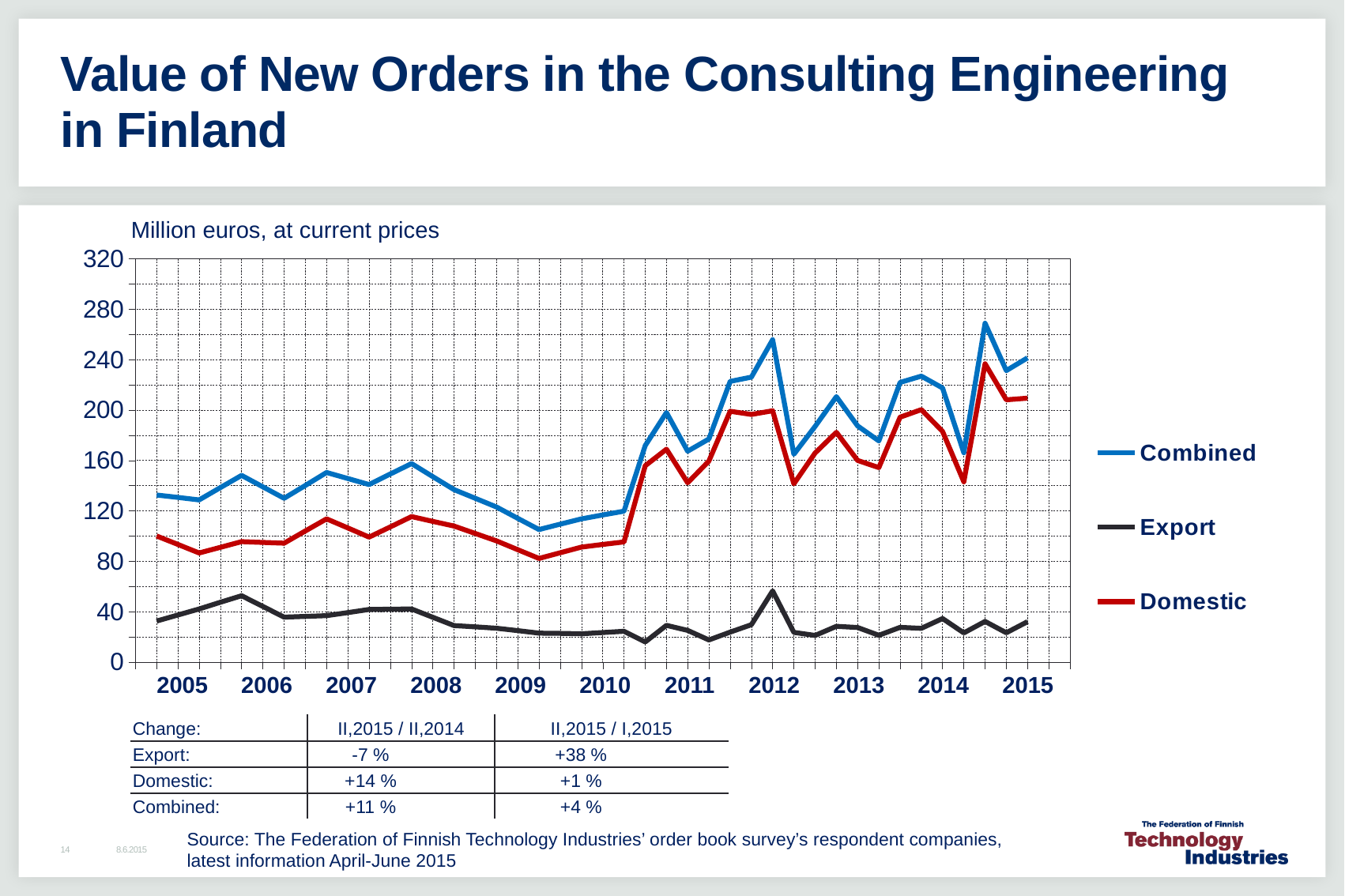
Which series has the highest values across the whole period? Combined Is the Combined value at its 2014 peak greater or less than 240? greater How many series does the legend list? 3 Is the Domestic value at its lowest point in 2009 greater or less than 120? less Is the Export value at its 2012 peak greater or less than 40? greater What unit is the chart measured in, according to the label above the plot? Million euros, at current prices Which series has the lowest values across the whole period? Export What kind of chart is shown on the slide? line chart Does the Domestic series generally rise or fall between 2009 and 2012? rise Is the Combined value higher at its 2012 peak or at the start of 2005? 2012 peak What are the series named in the legend? Combined, Export, Domestic